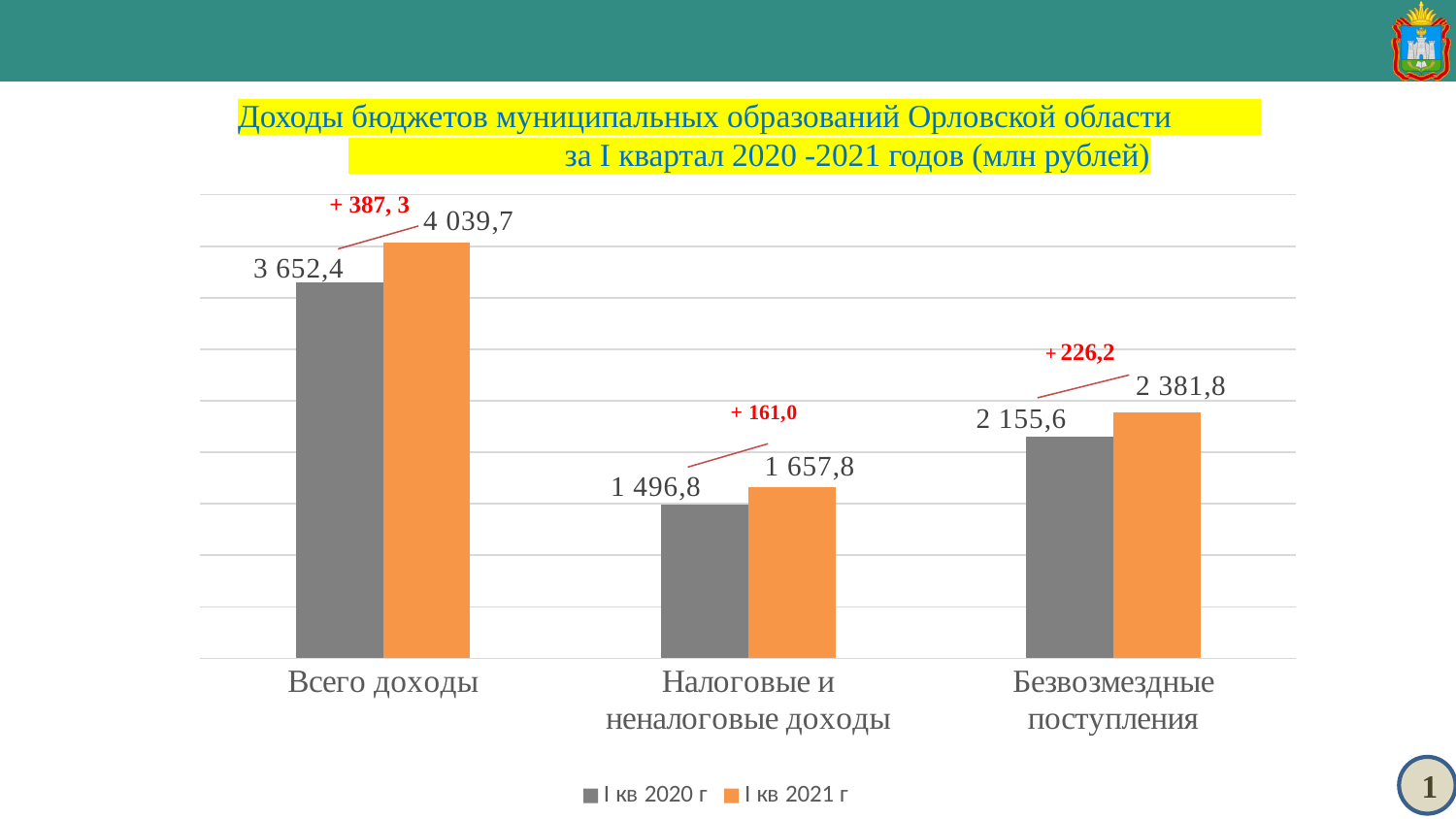
Which is larger for Безвозмездные поступления: the I кв 2020 г value or the I кв 2021 г value? I кв 2021 г What is the value for Всего доходы in the I кв 2021 г series? 4 039,7 What kind of chart is shown on the slide? Bar chart What is the value for Безвозмездные поступления in the I кв 2020 г series? 2 155,6 Which category has the lowest value in the I кв 2021 г series? Налоговые и неналоговые доходы Which category has the highest value in the I кв 2020 г series? Всего доходы What is the difference between the I кв 2021 г and I кв 2020 г values for Всего доходы? 387,3 How many categories are shown on the x axis? 3 What is the difference between the I кв 2021 г and I кв 2020 г values for Налоговые и неналоговые доходы? 161,0 What is the value for Налоговые и неналоговые доходы in the I кв 2020 г series? 1 496,8 How many series does the legend list? 2 What is the value for Безвозмездные поступления in the I кв 2021 г series? 2 381,8